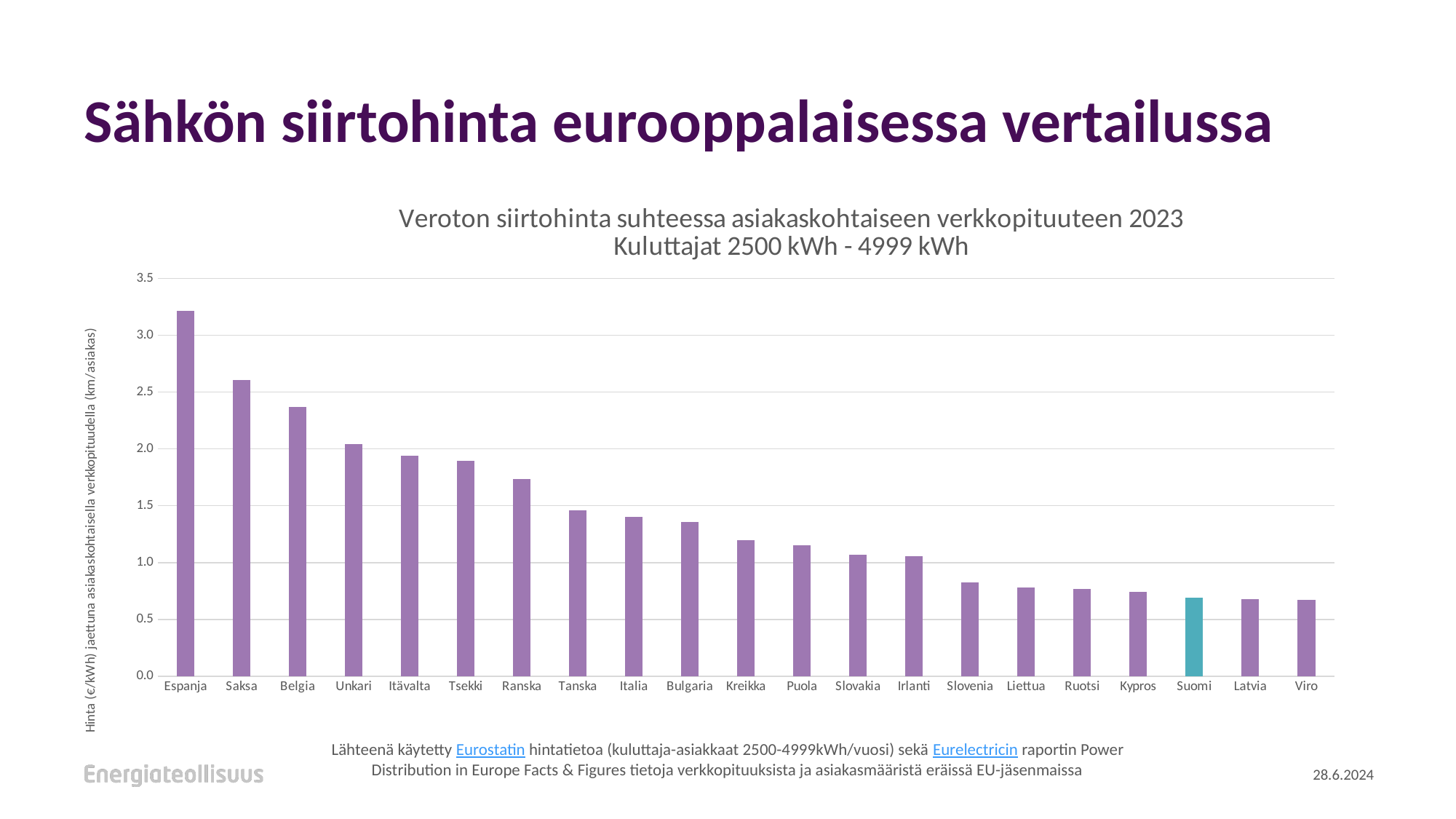
Is the value for Ranska greater or less than 1.5? greater Which country has the highest value in the chart? Espanja Which country's bar is shown in a different colour (teal) from the others? Suomi What kind of chart is shown on the slide? bar chart Which has the larger value, Saksa or Belgia? Saksa Do the values rise or fall from left to right along the x axis? fall Is the value for Suomi greater or less than 1.0? less Is the value for Saksa greater or less than 2.5? greater How many countries are shown on the x axis of the chart? 21